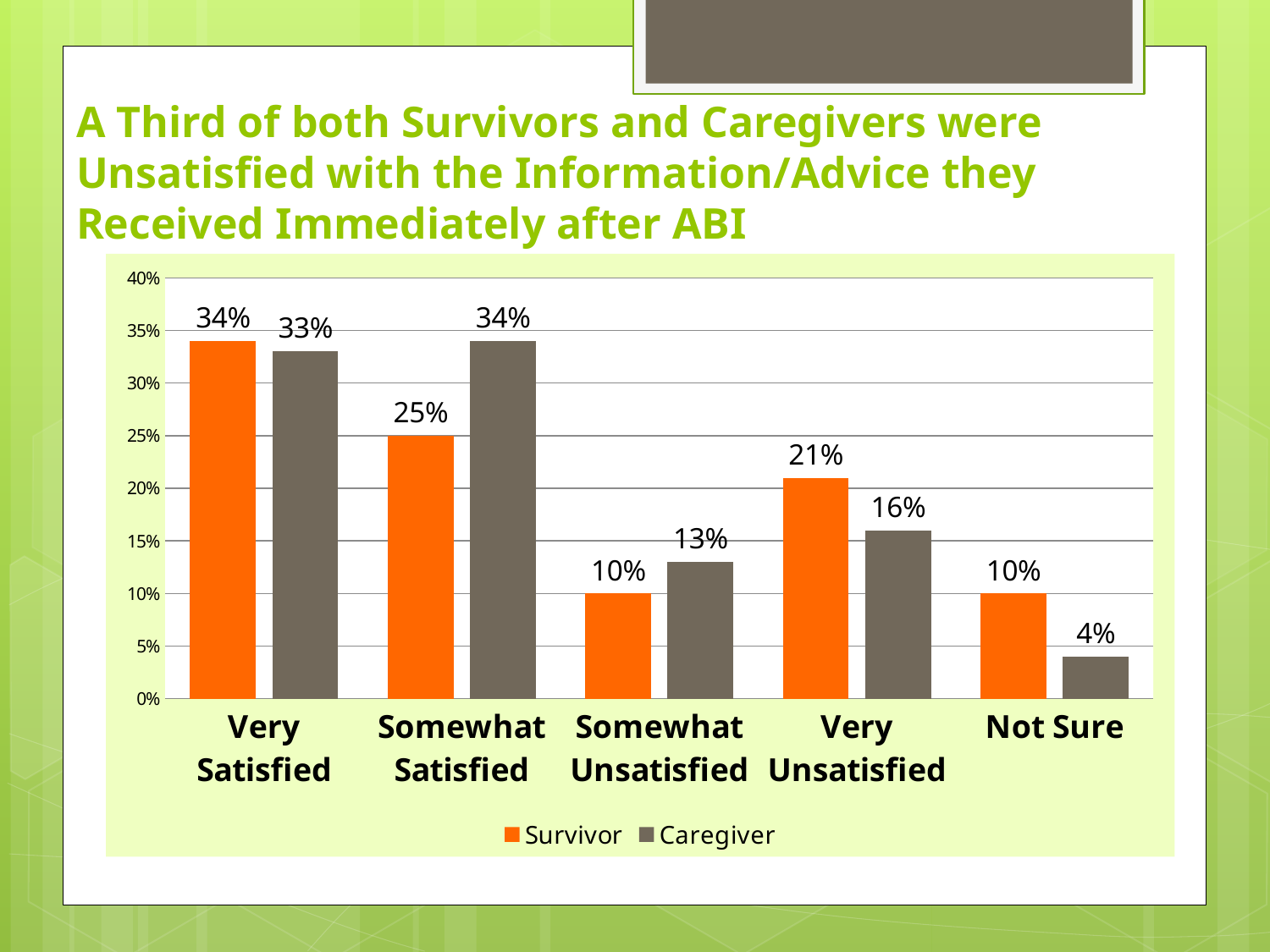
Which category has the highest value for Caregivers? Somewhat Satisfied What percentage of Caregivers were Somewhat Unsatisfied? 13% What percentage of Survivors were Very Satisfied? 34% Which colour represents the Survivor series? Orange What percentage of Caregivers answered Not Sure? 4% How many categories are shown on the x axis? 5 Is the Survivor value for Very Unsatisfied greater or less than 20%? greater Which is larger for Somewhat Satisfied: the Survivor value or the Caregiver value? Caregiver What kind of chart is shown on the slide? Bar chart Which category has the lowest value for Survivors? Somewhat Unsatisfied and Not Sure (both 10%) How many series does the legend list? 2 What is the difference between the Survivor and Caregiver values for Very Unsatisfied? 5%